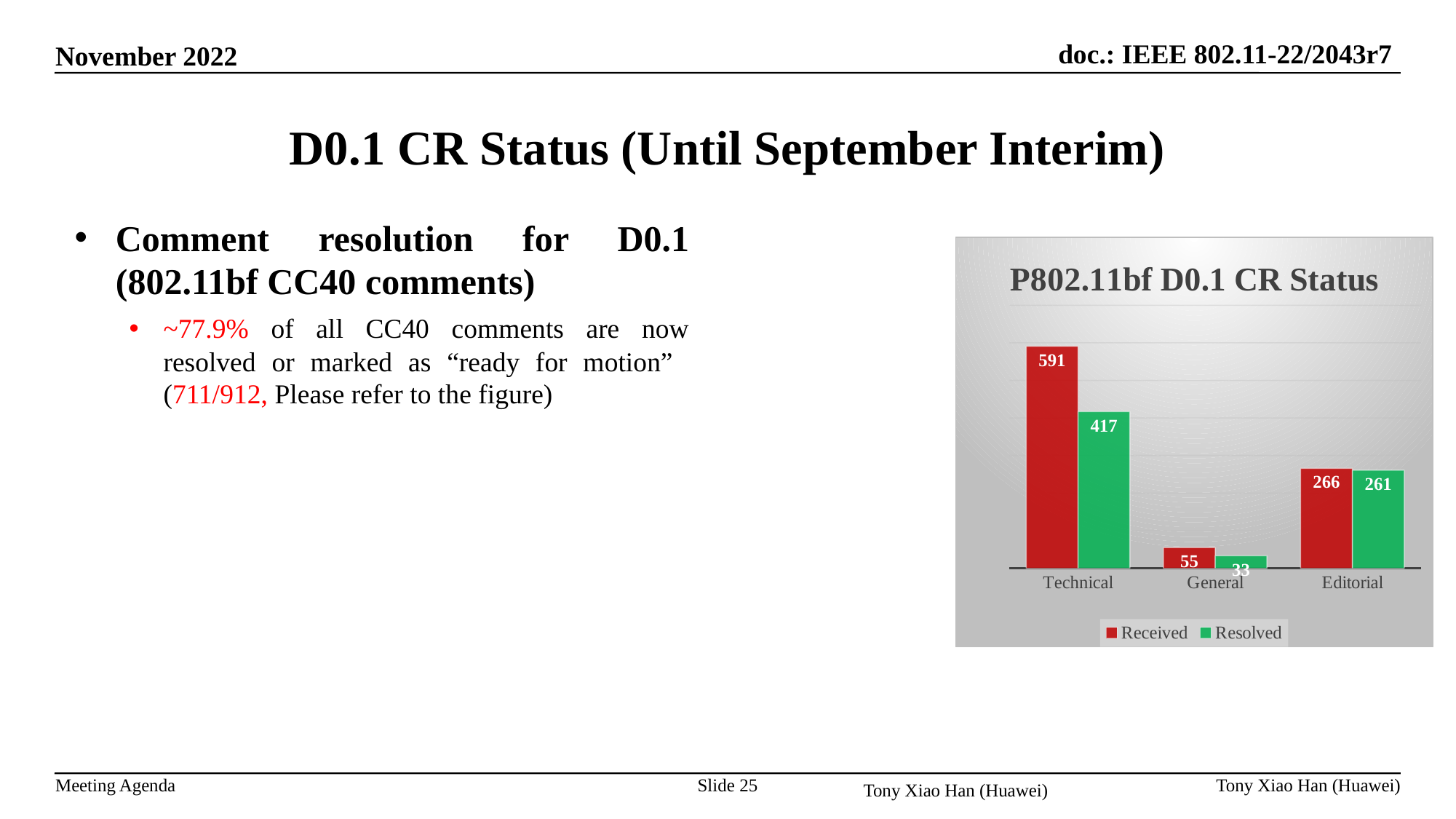
What is the Received value for Technical? 591 How many categories are shown on the x axis? 3 What is the difference between Received and Resolved for Technical? 174 What is the Resolved value for General? 33 What is the Resolved value for Editorial? 261 Is the Received value for Editorial larger than the Resolved value for Editorial? Yes How many series does the legend list? 2 What is the title of the chart? P802.11bf D0.1 CR Status Which category has the lowest Resolved value? General Which category has the highest Received value? Technical What kind of chart is shown? Bar chart What is the difference between Received and Resolved for General? 22